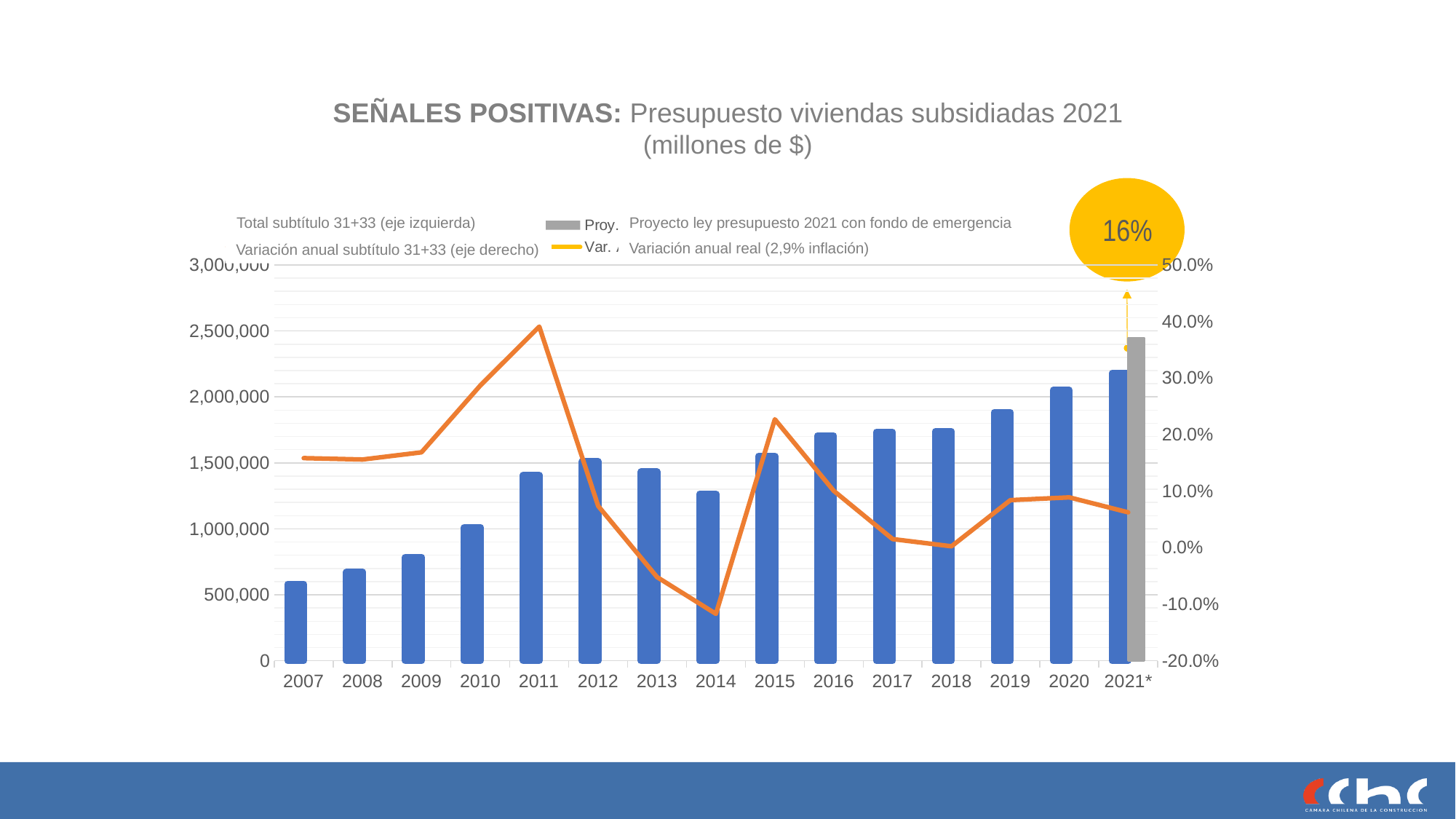
How many years are shown on the x axis of the chart? 15 In which year does the orange line reach its lowest point? 2014 Is the bar value for 2016 greater or less than 1,500,000? greater Which bar is taller, 2012 or 2014? 2012 Which year has the shortest bar in the chart? 2007 Is the orange line value for 2014 greater or less than 0.0%? less What kind of chart is shown on the slide? A combined bar and line chart In which year does the orange line reach its highest point? 2011 What percentage is shown in the yellow callout above the 2021* bar? 16% Is the bar value for 2007 greater or less than 1,000,000? less Which year has the tallest bar in the chart? 2021*